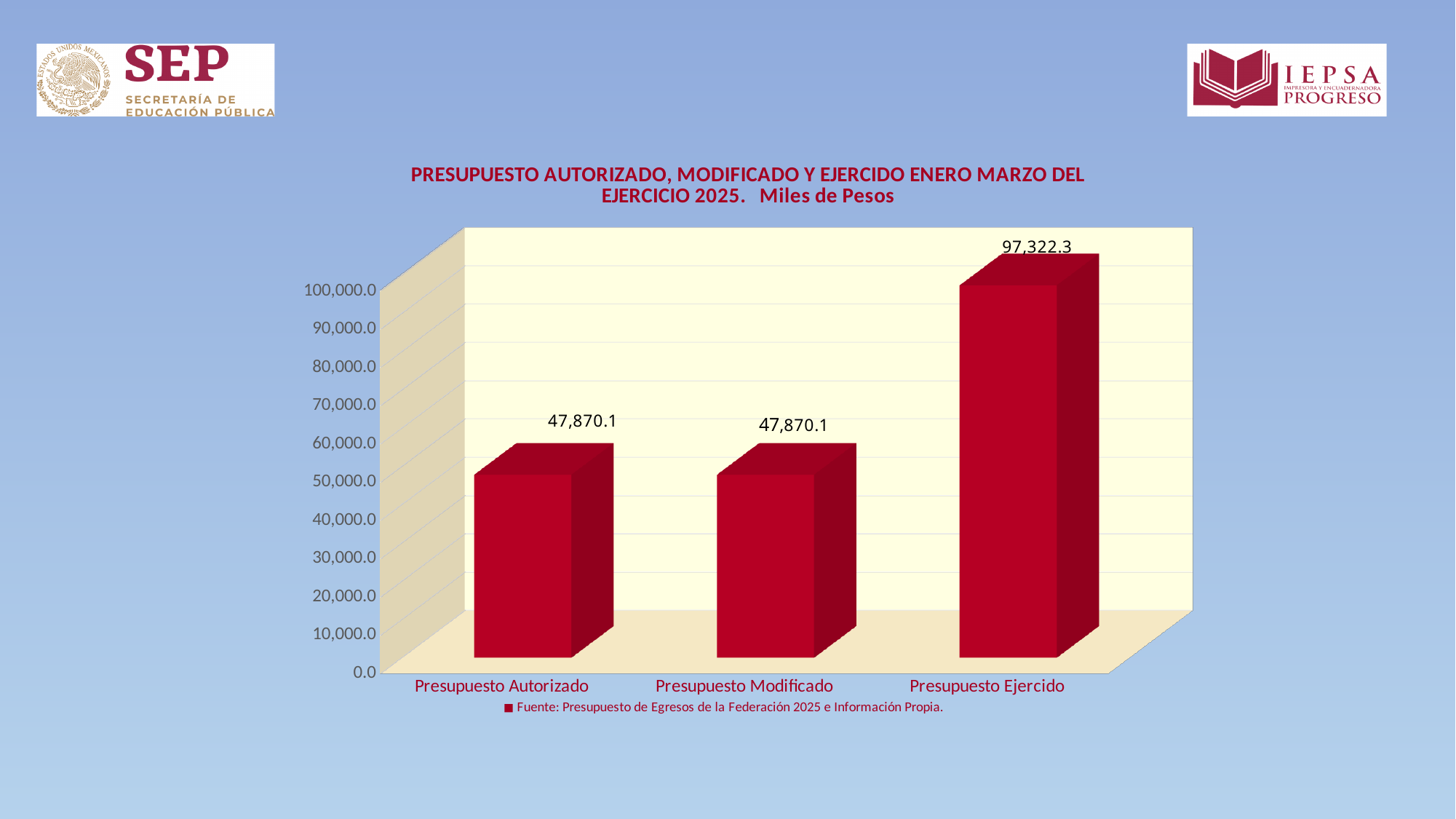
What unit of measurement does the chart title state the values are in? Miles de Pesos What is the difference between Presupuesto Ejercido and Presupuesto Autorizado? 49,452.2 What kind of chart is shown on the slide? Bar chart Which is larger, Presupuesto Ejercido or Presupuesto Modificado? Presupuesto Ejercido What is the value for Presupuesto Modificado? 47,870.1 How many categories are shown on the x axis? 3 Is the value for Presupuesto Autorizado greater or less than 50,000.0? less Are the values for Presupuesto Autorizado and Presupuesto Modificado equal? Yes What is the value for Presupuesto Ejercido? 97,322.3 What is the value for Presupuesto Autorizado? 47,870.1 Which category has the highest value? Presupuesto Ejercido Is the value for Presupuesto Ejercido greater or less than 90,000.0? greater